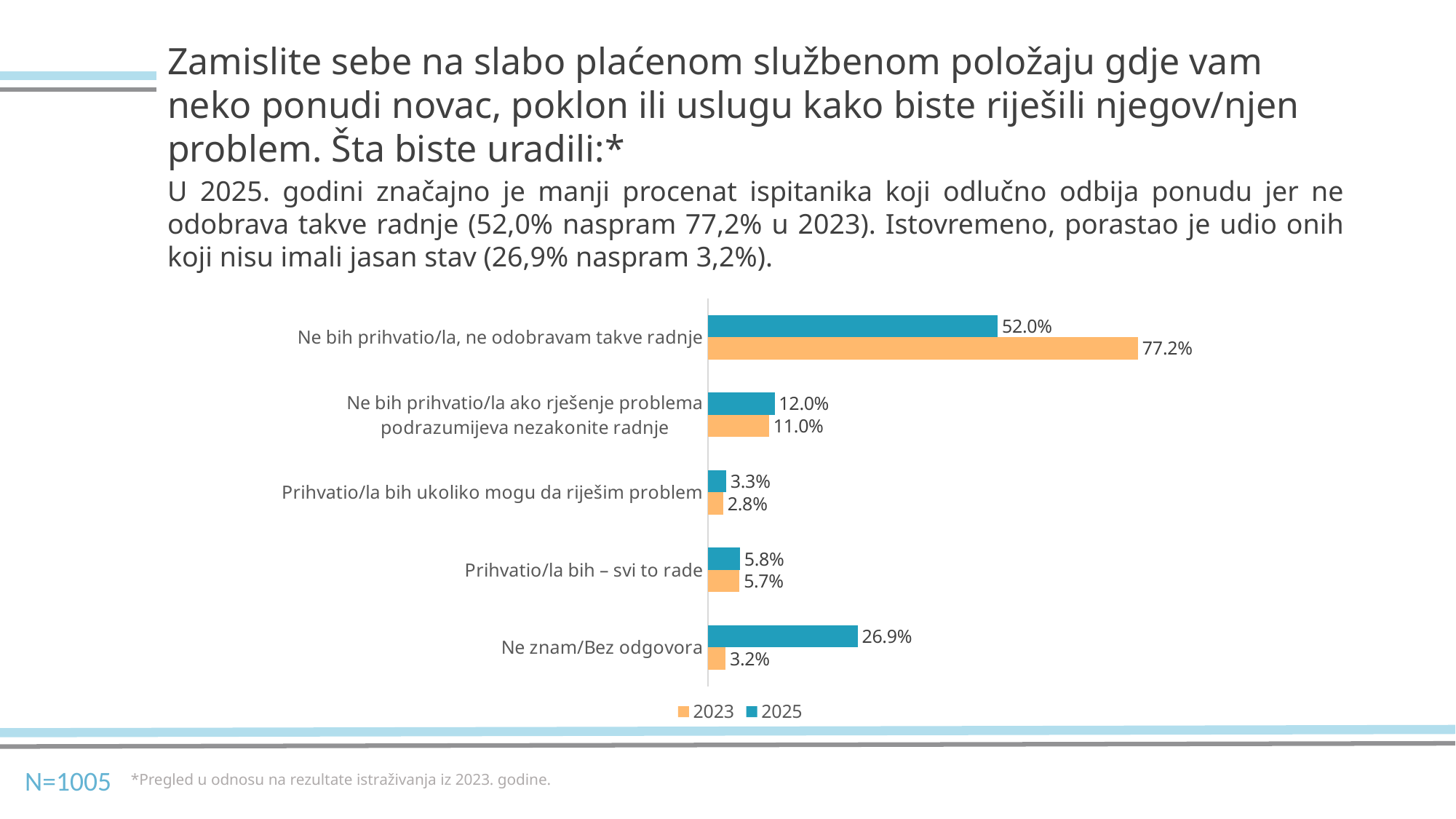
What is the difference between the 2025 and 2023 values for "Ne znam/Bez odgovora"? 23.7% Which colour represents the 2023 series in the chart? Orange How many series does the legend list? 2 How many categories are shown in the chart? 5 What kind of chart is shown on the slide? Bar chart What is the difference between the 2023 and 2025 values for "Ne bih prihvatio/la, ne odobravam takve radnje"? 25.2% For "Ne znam/Bez odgovora", which year has the larger value, 2023 or 2025? 2025 What is the 2025 value for "Ne bih prihvatio/la, ne odobravam takve radnje"? 52.0% What is the 2023 value for "Ne bih prihvatio/la ako rješenje problema podrazumijeva nezakonite radnje"? 11.0% What is the 2023 value for "Ne znam/Bez odgovora"? 3.2% Which category has the lowest 2023 value? Prihvatio/la bih ukoliko mogu da riješim problem Which category has the highest 2025 value? Ne bih prihvatio/la, ne odobravam takve radnje